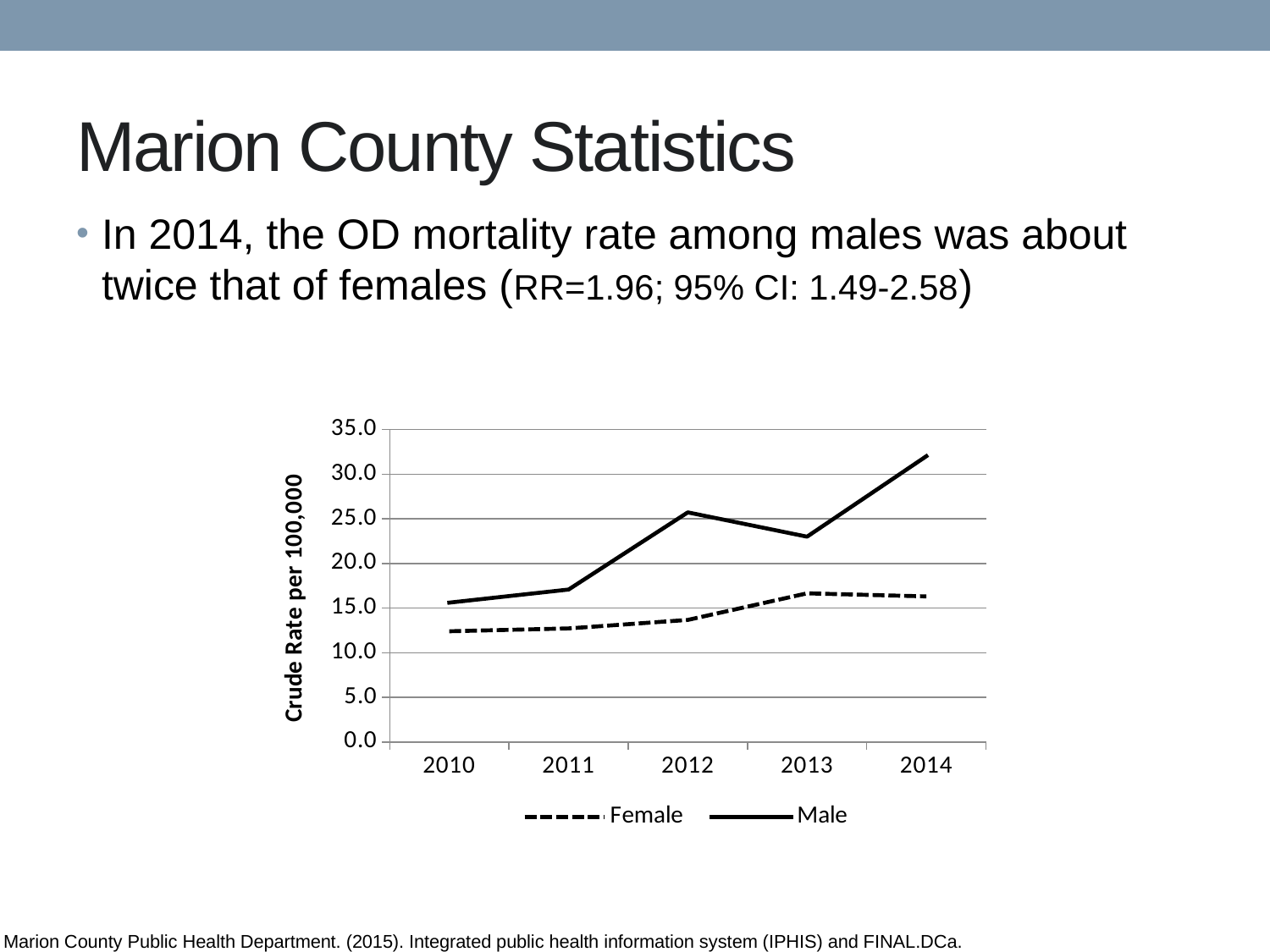
Does the Male crude rate rise or fall overall from 2010 to 2014? Rise What kind of chart is shown on the slide? Line chart Is the Male crude rate in 2011 greater or less than 20.0? less Is the Female crude rate in 2013 greater or less than 20.0? less How many series does the chart's legend list? 2 Is the Male crude rate in 2014 greater or less than 30.0? greater What is the title of the chart's vertical axis? Crude Rate per 100,000 In 2014, which series has the higher crude rate, Male or Female? Male In which year is the Male crude rate lowest? 2010 How many years are plotted along the x axis of the chart? 5 In which year is the Male crude rate highest? 2014